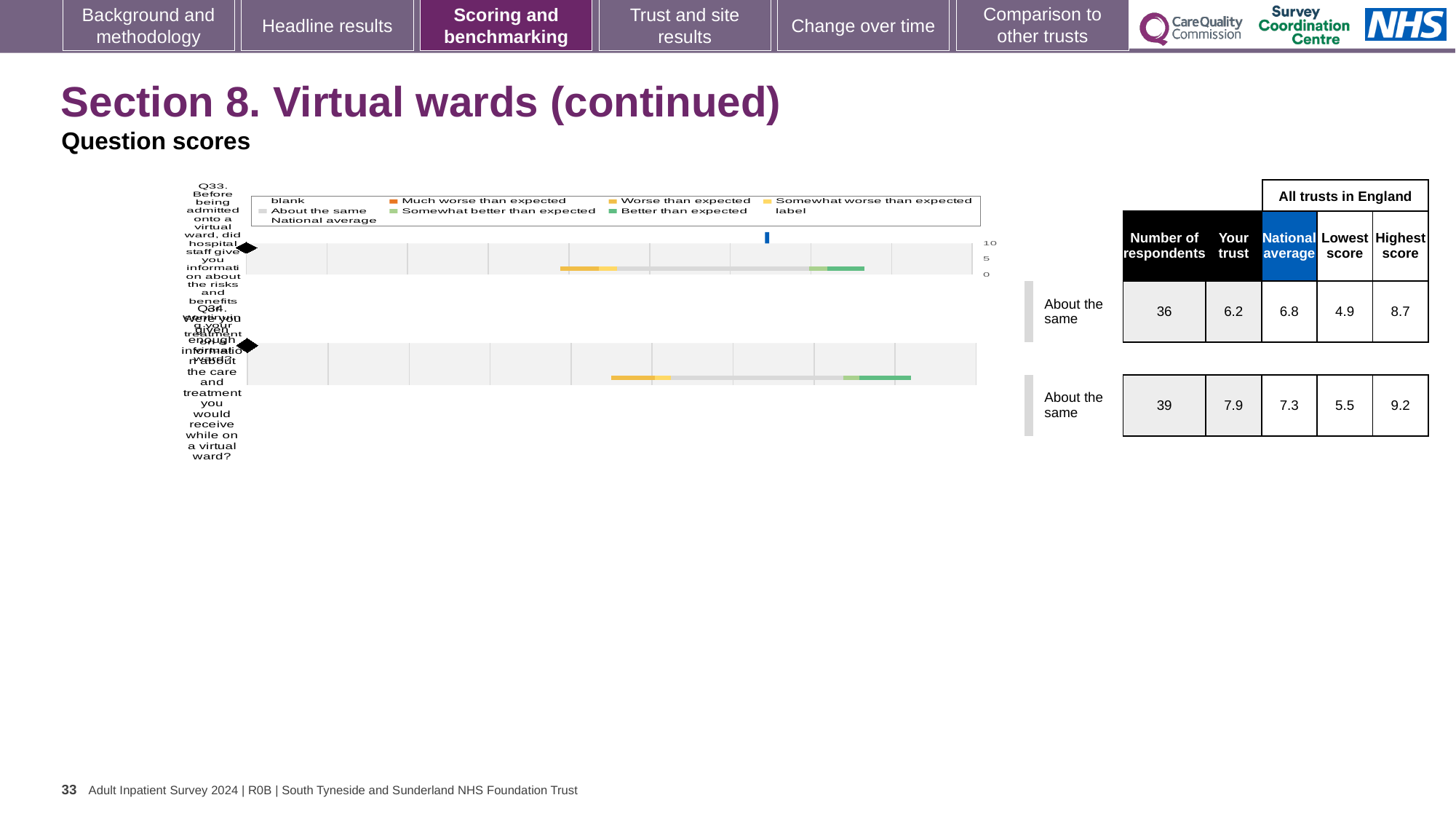
What is the 'Your trust' score for Q34 (information about the care and treatment on a virtual ward)? 7.9 What is the national average score for Q33? 6.8 What is the difference between the 'Your trust' score and the national average for Q34? 0.6 What kind of chart is used to show the question scores on this slide? Bar chart For Q34, which is larger: the 'Your trust' score or the national average? Your trust How many respondents answered Q34? 39 What benchmark category is shown next to the bar for Q33? About the same How many questions are plotted in the chart on this slide? 2 What is the 'Your trust' score for Q33 (information about the risks and benefits of a virtual ward)? 6.2 What is the highest score across all trusts in England for Q34? 9.2 Which question has the higher 'Your trust' score, Q33 or Q34? Q34 What is the difference between the highest score and the lowest score for Q33? 3.8